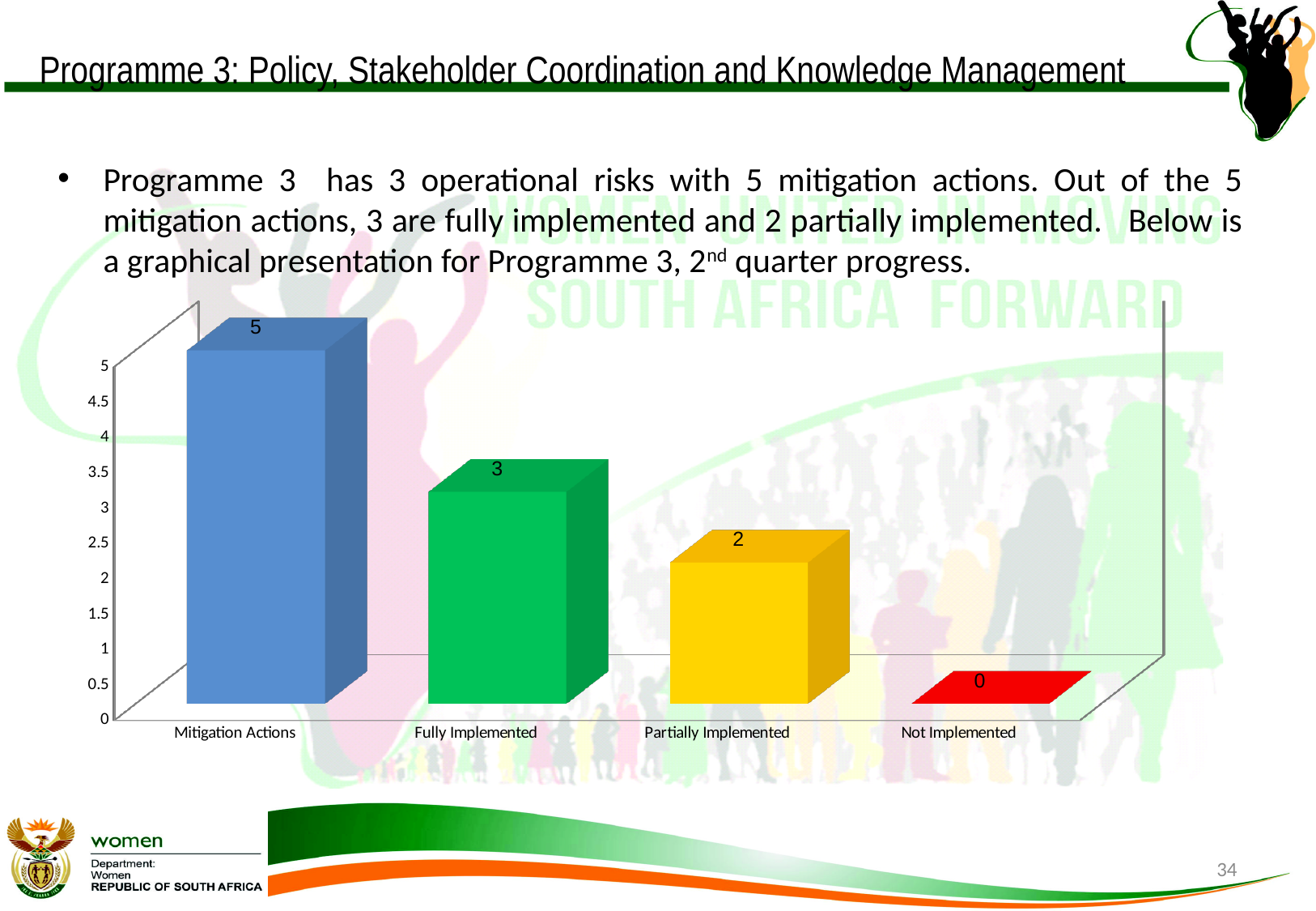
Which category has the lowest value? Not Implemented What is the value for Fully Implemented? 3 What is the value for Not Implemented? 0 Which is larger, Fully Implemented or Partially Implemented? Fully Implemented What is the value for Mitigation Actions? 5 What is the difference between Fully Implemented and Partially Implemented? 1 What is the difference between Mitigation Actions and Fully Implemented? 2 What kind of chart is shown on the slide? Bar chart Do the values rise or fall from left to right along the x axis? Fall How many categories are shown on the x axis? 4 What is the value for Partially Implemented? 2 Which category has the highest value? Mitigation Actions